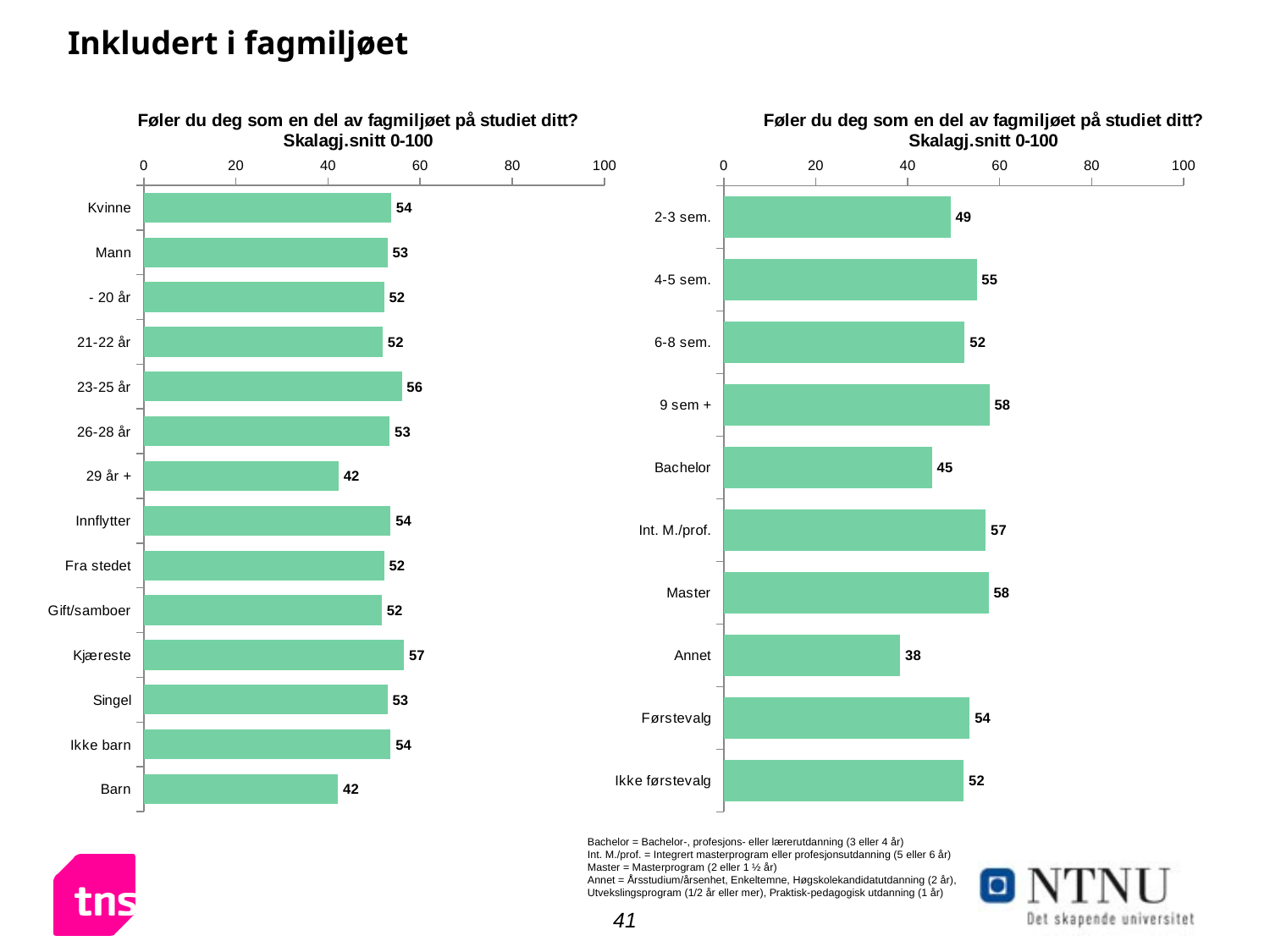
On the left chart, which is larger, the value for 23-25 år or the value for Barn? 23-25 år On the left chart, what is the difference between the values for Kvinne and Mann? 1 On the right chart, what is the value for Int. M./prof.? 57 On the right chart, what is the value for Annet? 38 How many categories are shown on the right chart? 10 On the left chart, what is the value for Kjæreste? 57 On the right chart, which category has the lowest value? Annet On the left chart, what is the value for 29 år +? 42 How many categories are shown on the left chart? 14 On the left chart, which category has the highest value? Kjæreste What type of chart is the right chart? Bar chart On the right chart, what is the difference between the values for Førstevalg and Ikke førstevalg? 2